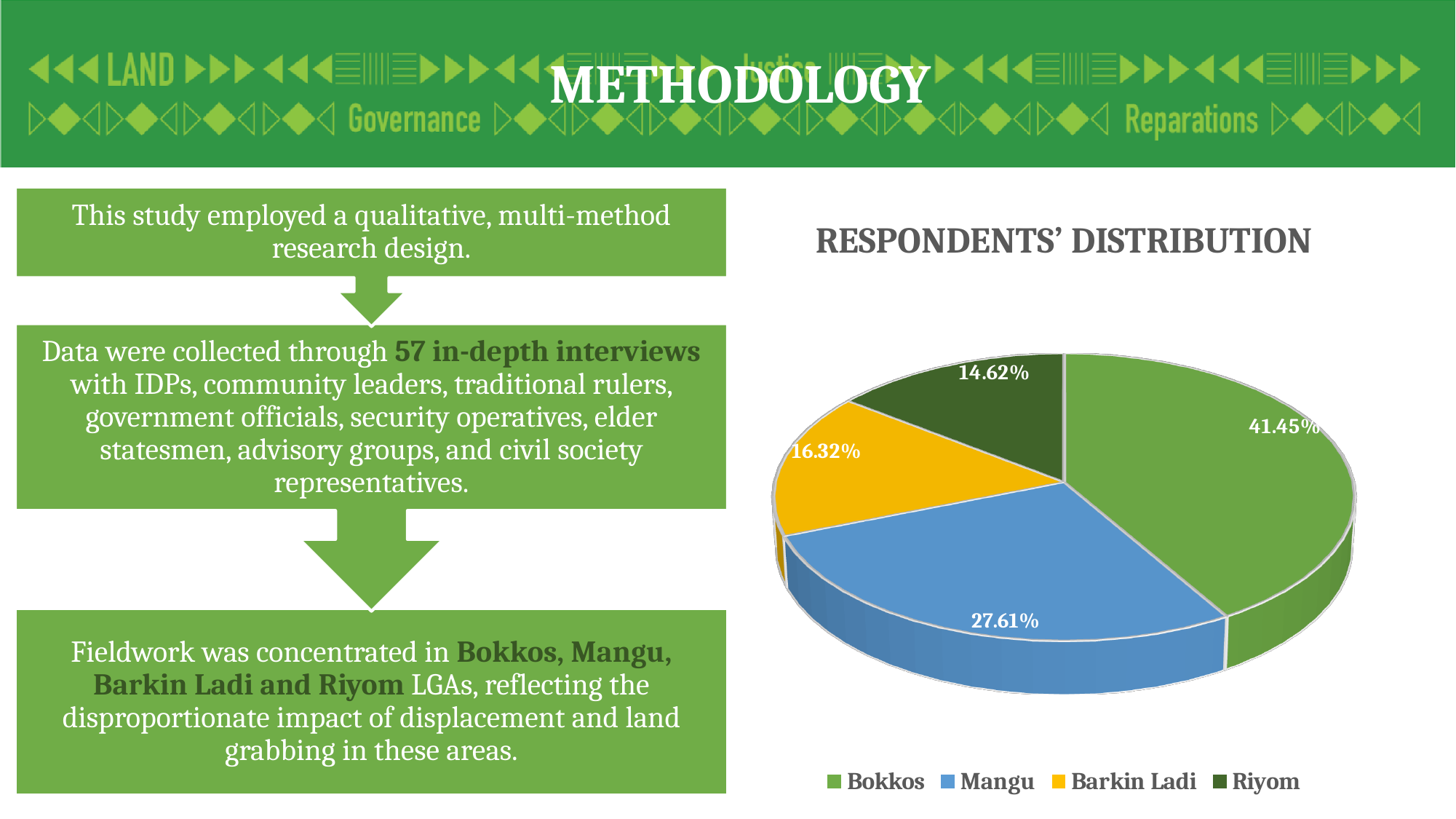
What is the difference in percentage points between Bokkos and Mangu? 13.84 Which has a larger share of respondents, Barkin Ladi or Mangu? Mangu Which colour represents Barkin Ladi in the chart? yellow How many categories does the pie chart show? 4 Which LGA has the largest share of respondents? Bokkos What percentage of respondents are from Riyom? 14.62% What is the title of the chart? RESPONDENTS' DISTRIBUTION Which LGA has the smallest share of respondents? Riyom What percentage of respondents are from Mangu? 27.61% What percentage of respondents are from Bokkos? 41.45% What type of chart is shown on the slide? pie chart What percentage of respondents are from Barkin Ladi? 16.32%